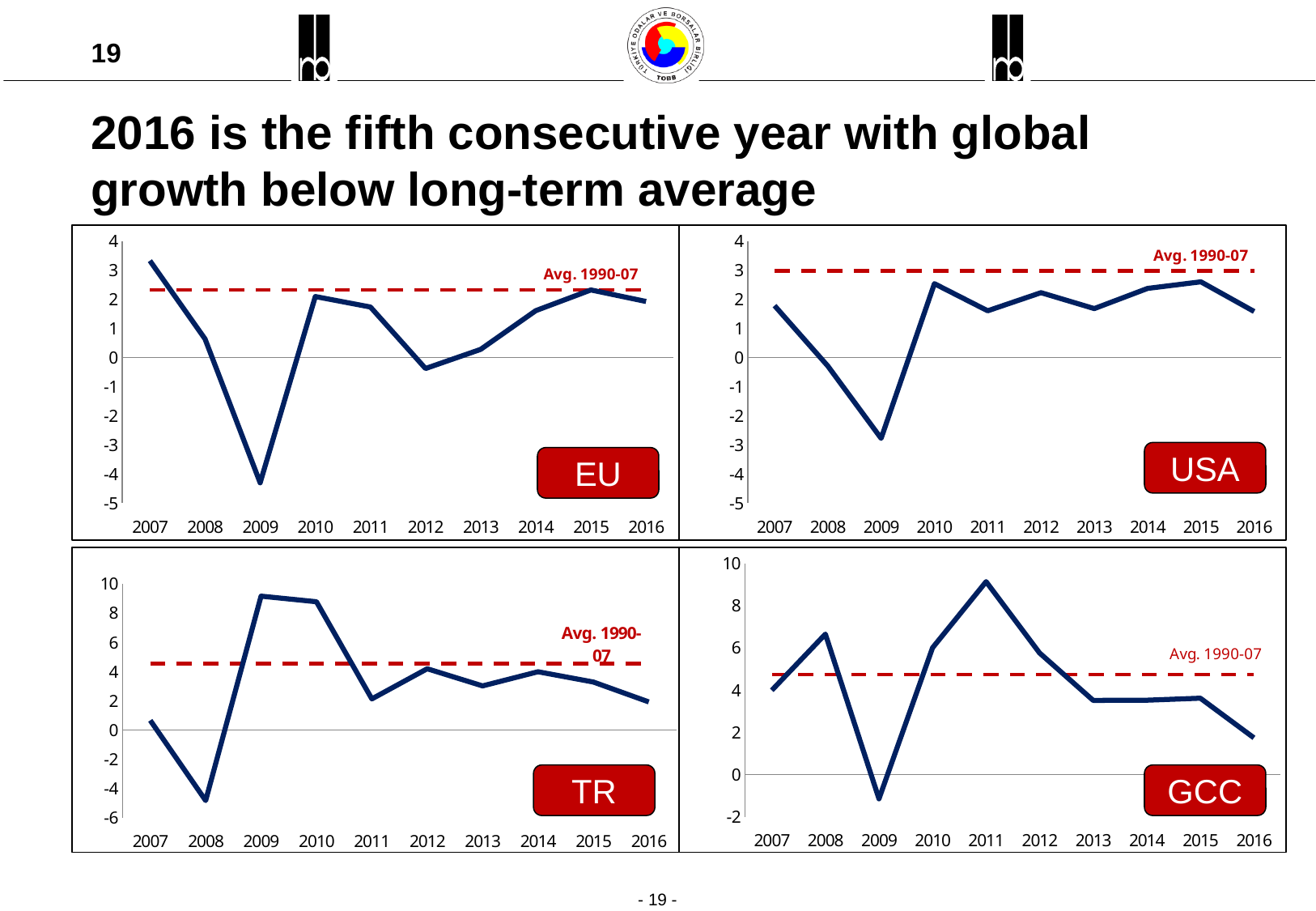
What does the red dashed line in the USA chart represent, according to its label? Avg. 1990-07 In the GCC chart, do the values rise or fall from 2011 to 2016? fall In the EU chart, is the value for 2009 greater or less than -3? less In the TR chart, is the value for 2009 greater or less than 8? greater In the USA chart, which year has the lowest value? 2009 In the EU chart, which year has the highest value? 2007 In the USA chart, is the value for 2009 greater or less than -2? less What kind of chart is the EU chart? line chart In the GCC chart, which year has the highest value? 2011 How many years are plotted on the x axis of the GCC chart? 10 In the EU chart, which year has the lowest value? 2009 In the TR chart, which year has the lowest value? 2008